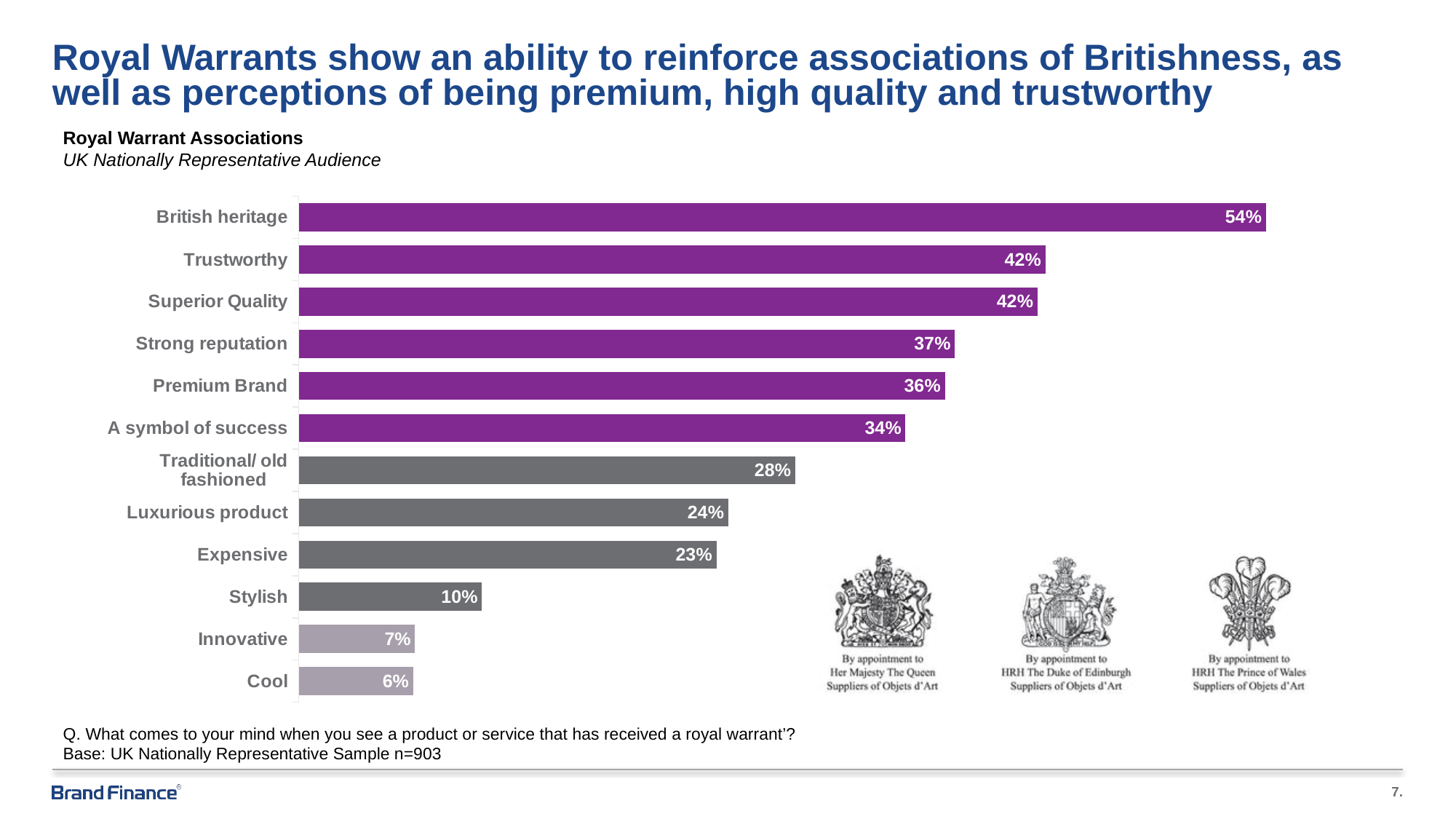
Which association has the lowest value? Cool Which is larger, the value for Strong reputation or the value for A symbol of success? Strong reputation What is the difference between the values for Luxurious product and Expensive? 1 percentage point What is the difference between the values for British heritage and Trustworthy? 12 percentage points How many associations (categories) are shown in the chart? 12 What percentage of respondents associate Royal Warrants with British heritage? 54% What is the title of the chart? Royal Warrant Associations Which association has the highest value? British heritage Which is larger, the value for Stylish or the value for Innovative? Stylish What is the value shown for Premium Brand? 36% What is the value shown for Traditional/ old fashioned? 28% What kind of chart is shown on the slide? Bar chart